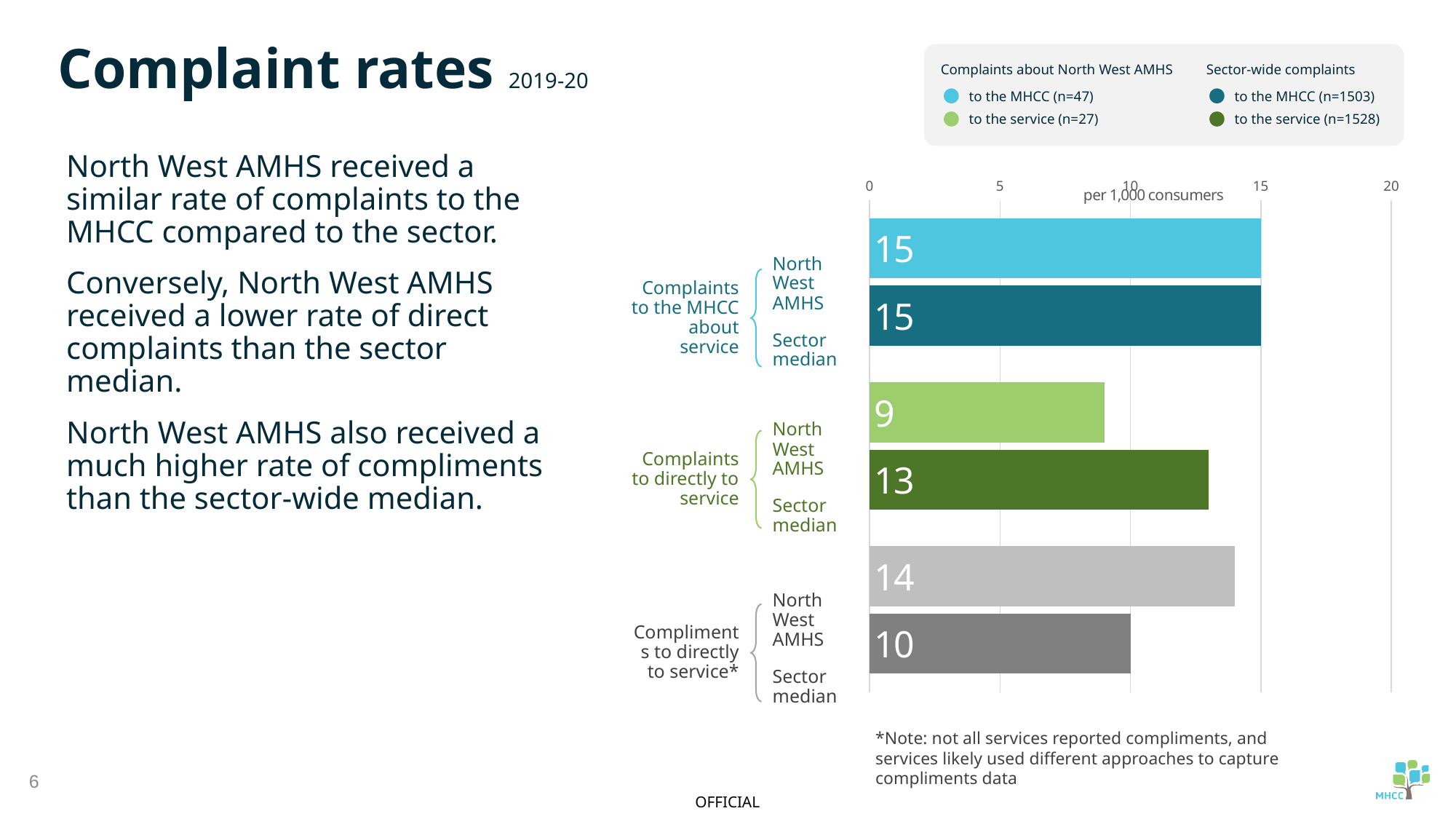
What is the rate of complaints to the MHCC about North West AMHS, per 1,000 consumers? 15 What is the rate of compliments made directly to the service for North West AMHS? 14 Which bar in the chart has the lowest value? North West AMHS, complaints directly to service For complaints made directly to the service, which is larger: North West AMHS or the sector median? Sector median What is the difference between the sector median and North West AMHS for complaints made directly to the service? 4 For compliments made directly to the service, which is larger: North West AMHS or the sector median? North West AMHS What unit is the chart's axis measured in? per 1,000 consumers What type of chart is shown on the slide? Bar chart What is the sector median rate of complaints made directly to the service? 13 What is the sector median rate of compliments made directly to the service? 10 What is the difference between North West AMHS and the sector median for compliments made directly to the service? 4 How many bars are plotted in the chart? 6